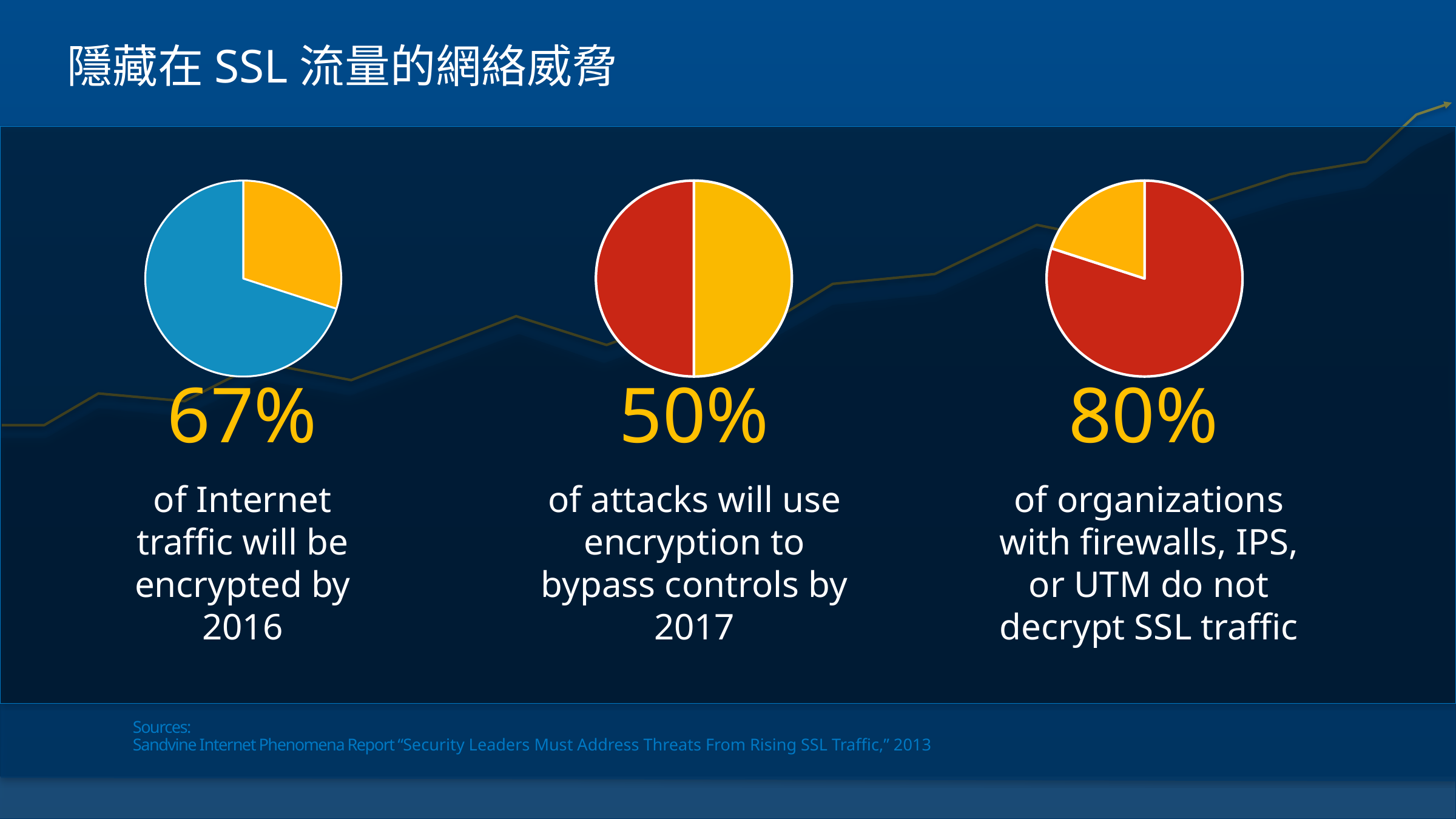
How many slices does the middle pie chart have? 2 What is the difference between the percentage in the left pie chart and the percentage in the middle pie chart? 17% In the left pie chart, what percentage of Internet traffic will be encrypted by 2016? 67% What kind of chart is used for the three figures on the slide? pie chart How many pie charts are shown on the slide? 3 In the left pie chart, which slice is larger, the blue slice or the yellow slice? the blue slice In the right pie chart, which slice is larger, the red slice or the yellow slice? the red slice Which of the three pie charts shows the lowest highlighted percentage? the middle pie chart (50%) In the right pie chart, what percentage of organizations with firewalls, IPS, or UTM do not decrypt SSL traffic? 80% Which of the three pie charts shows the highest highlighted percentage? the right pie chart (80%) In the middle pie chart, what percentage of attacks will use encryption to bypass controls by 2017? 50% What is the difference between the percentage in the right pie chart and the percentage in the left pie chart? 13%